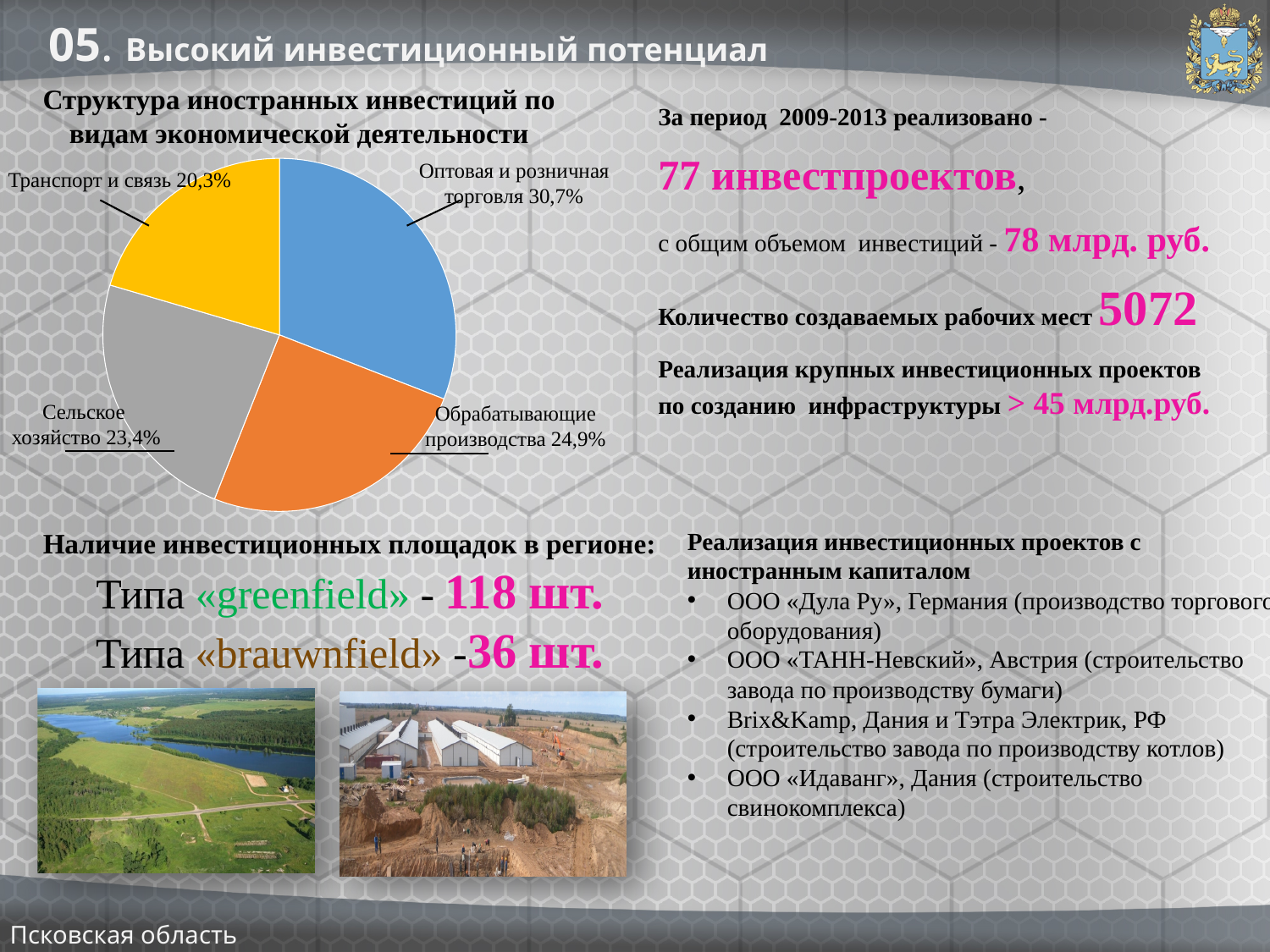
How many slices does the pie chart have? 4 What is the difference in percentage points between Оптовая и розничная торговля and Транспорт и связь? 10,4 What share of foreign investment goes to Сельское хозяйство? 23,4% What share of foreign investment goes to Транспорт и связь? 20,3% What share of foreign investment goes to Оптовая и розничная торговля? 30,7% Which has a larger share: Обрабатывающие производства or Транспорт и связь? Обрабатывающие производства What is the difference in percentage points between Обрабатывающие производства and Сельское хозяйство? 1,5 What type of chart is shown on the slide? Pie chart Which type of economic activity has the largest share of foreign investment? Оптовая и розничная торговля Which type of economic activity has the smallest share of foreign investment? Транспорт и связь What colour is the slice for Сельское хозяйство? Gray What share of foreign investment goes to Обрабатывающие производства? 24,9%